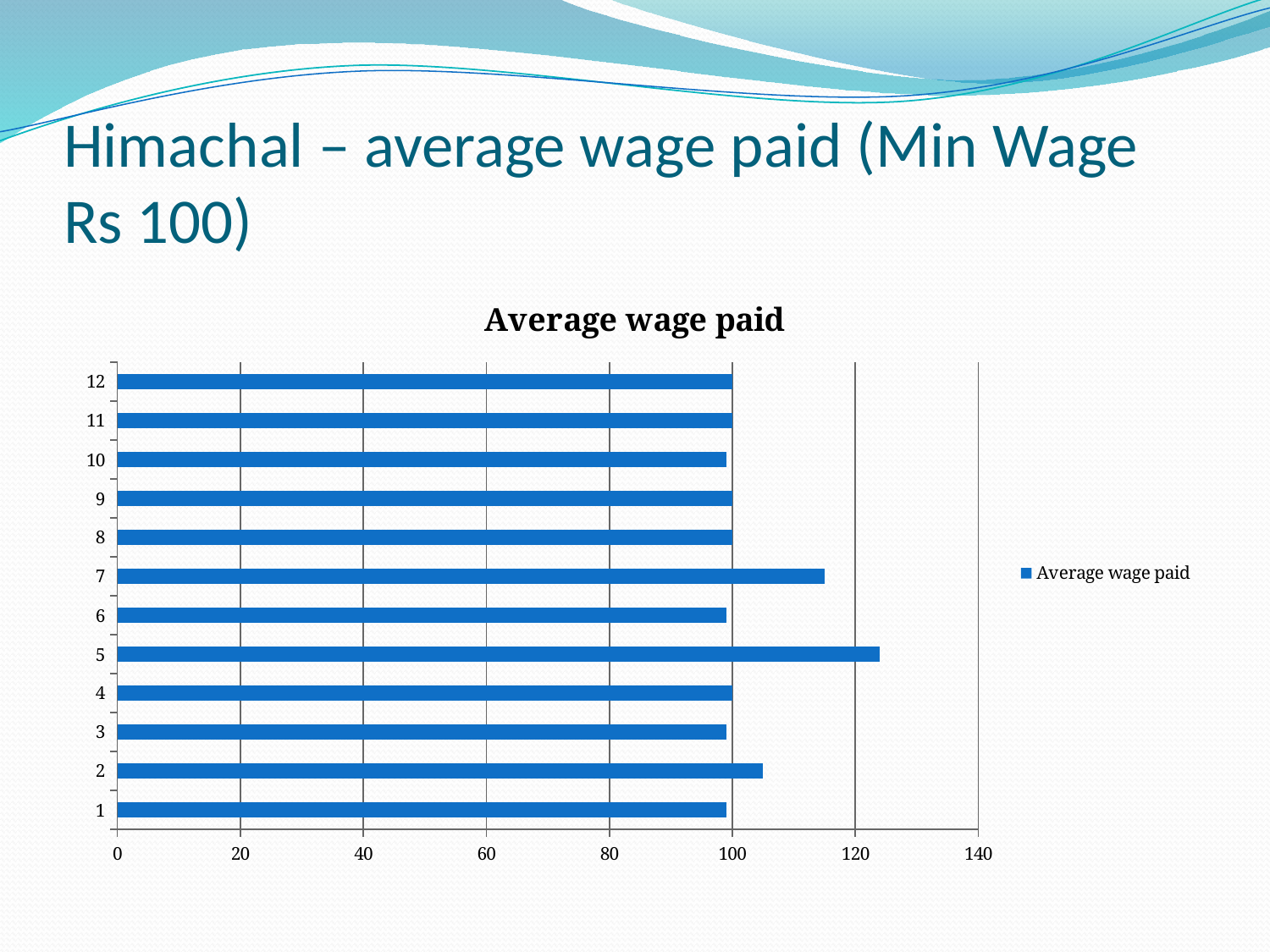
Is the value for category 7 greater or less than 120? less Is the value for category 2 greater or less than 120? less Which has the larger value, category 5 or category 7? 5 What is the title of the chart? Average wage paid How many series does the legend list? 1 Is the value for category 7 greater or less than 100? greater What kind of chart is shown on the slide? bar chart What is the name of the series shown in the legend? Average wage paid How many categories are plotted on the chart? 12 Which has the larger value, category 7 or category 2? 7 Which category has the highest average wage paid? 5